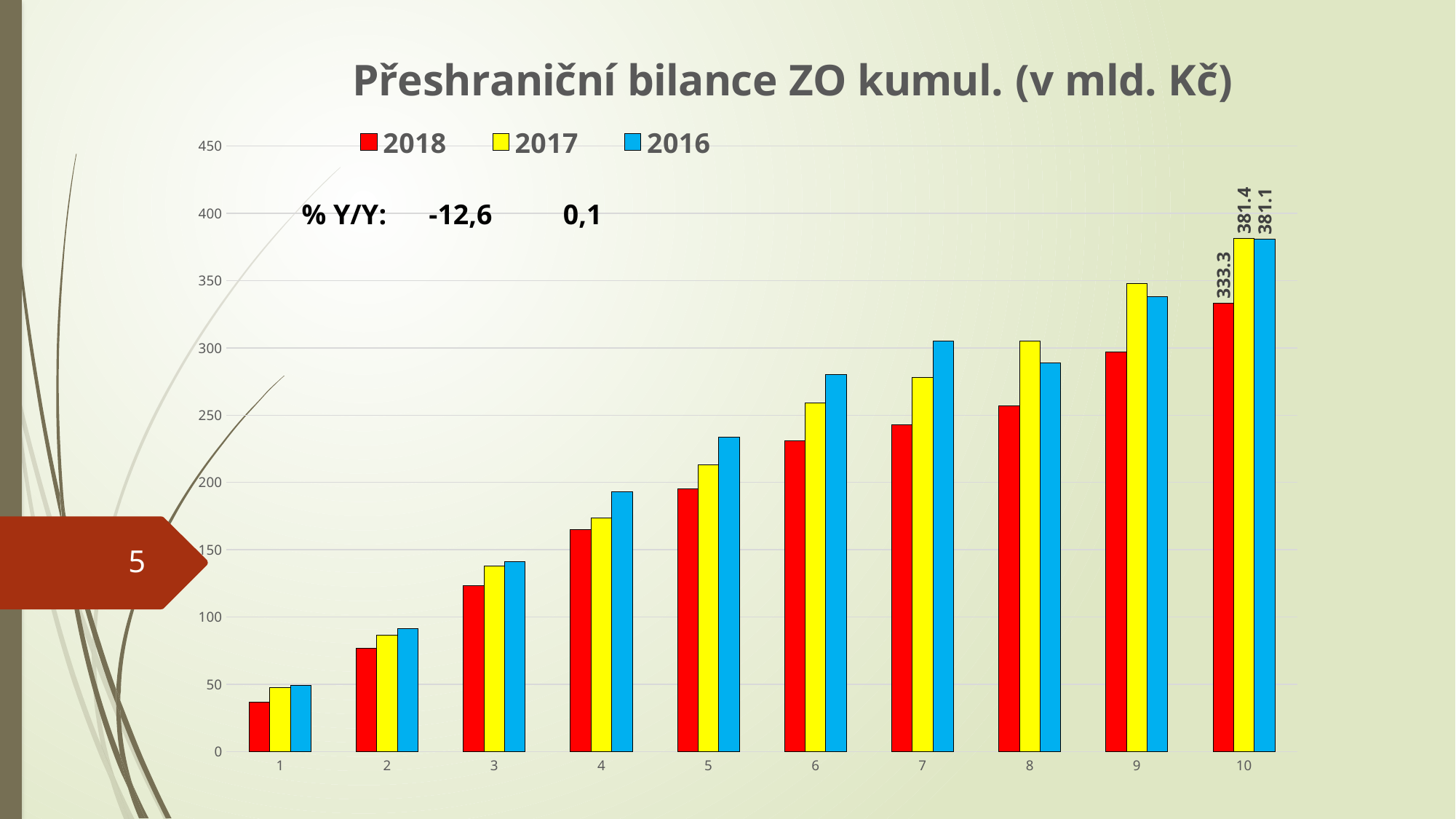
Do the values for the 2018 series rise or fall from category 1 to category 10? rise Is the value for 2018 at category 1 greater or less than 50? less How many categories are shown on the x axis? 10 Is the value for 2018 at category 5 greater or less than 200? less What is the value for 2018 at category 10? 333.3 How many series does the legend list? 3 At category 10, which is larger: the 2018 value or the 2017 value? 2017 What is the difference between the 2017 and 2018 values at category 10? 48.1 What kind of chart is shown on the slide? bar chart What is the value for 2017 at category 10? 381.4 What is the value for 2016 at category 10? 381.1 Is the value for 2016 at category 7 greater or less than 300? greater